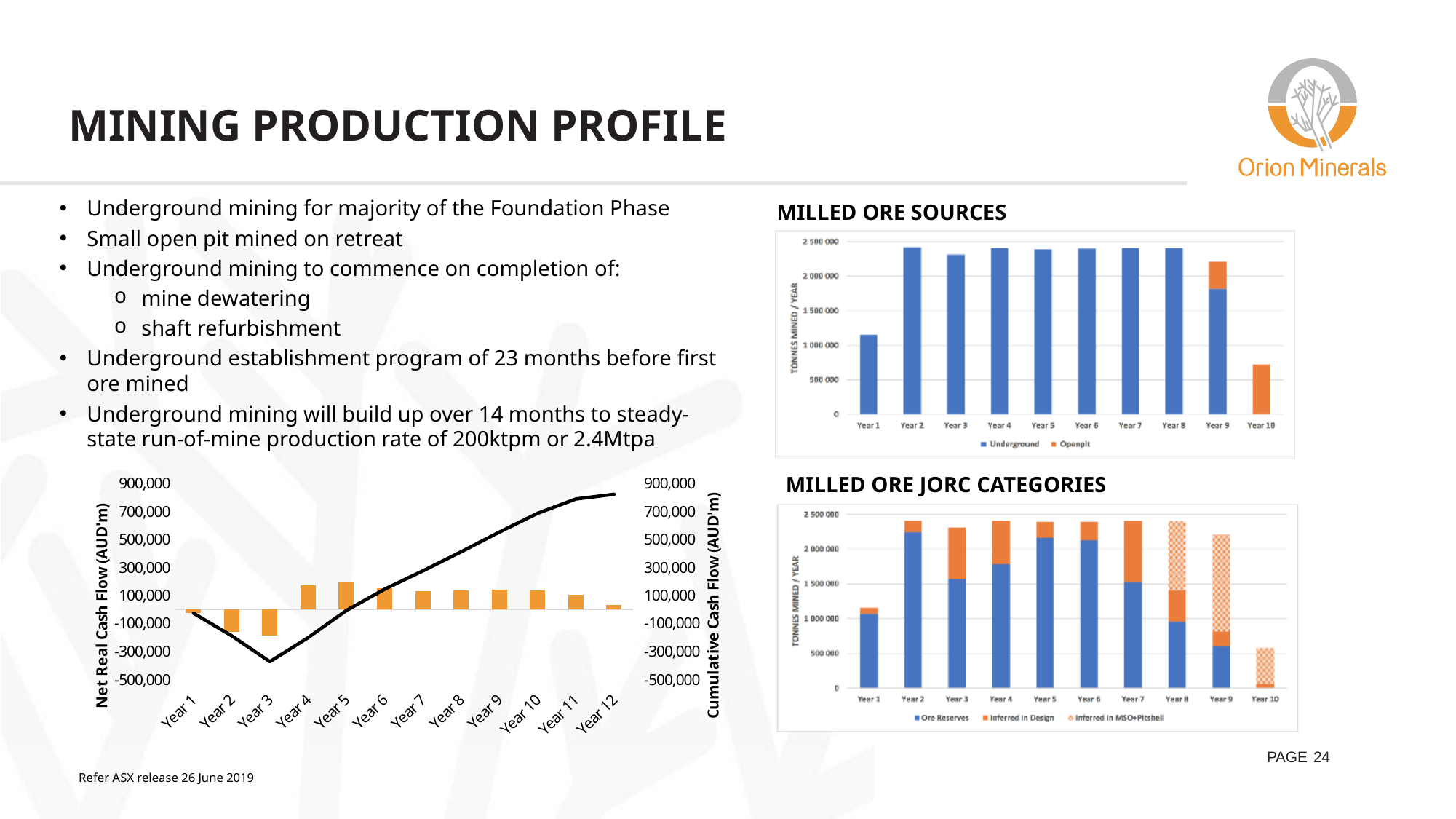
In the MILLED ORE SOURCES chart, how many years are shown on the x axis? 10 In the MILLED ORE SOURCES chart, how many series does the legend list? 2 In the cash flow chart at the bottom left, how many years are shown on the x axis? 12 In the MILLED ORE JORC CATEGORIES chart, which year has the lowest total tonnes mined? Year 10 In the MILLED ORE JORC CATEGORIES chart, which is larger: the Ore Reserves value for Year 2 or for Year 9? Year 2 In the cash flow chart at the bottom left, in which year is the Net Real Cash Flow bar lowest? Year 3 In the MILLED ORE SOURCES chart, is the Openpit value for Year 10 greater or less than 1 000 000? less In the MILLED ORE JORC CATEGORIES chart, how many series does the legend list? 3 In the MILLED ORE JORC CATEGORIES chart, is the Ore Reserves value for Year 2 greater or less than 2 000 000? greater In the cash flow chart at the bottom left, is the Cumulative Cash Flow value for Year 12 greater or less than 700,000? greater In the MILLED ORE SOURCES chart, which year has the lowest total tonnes mined? Year 10